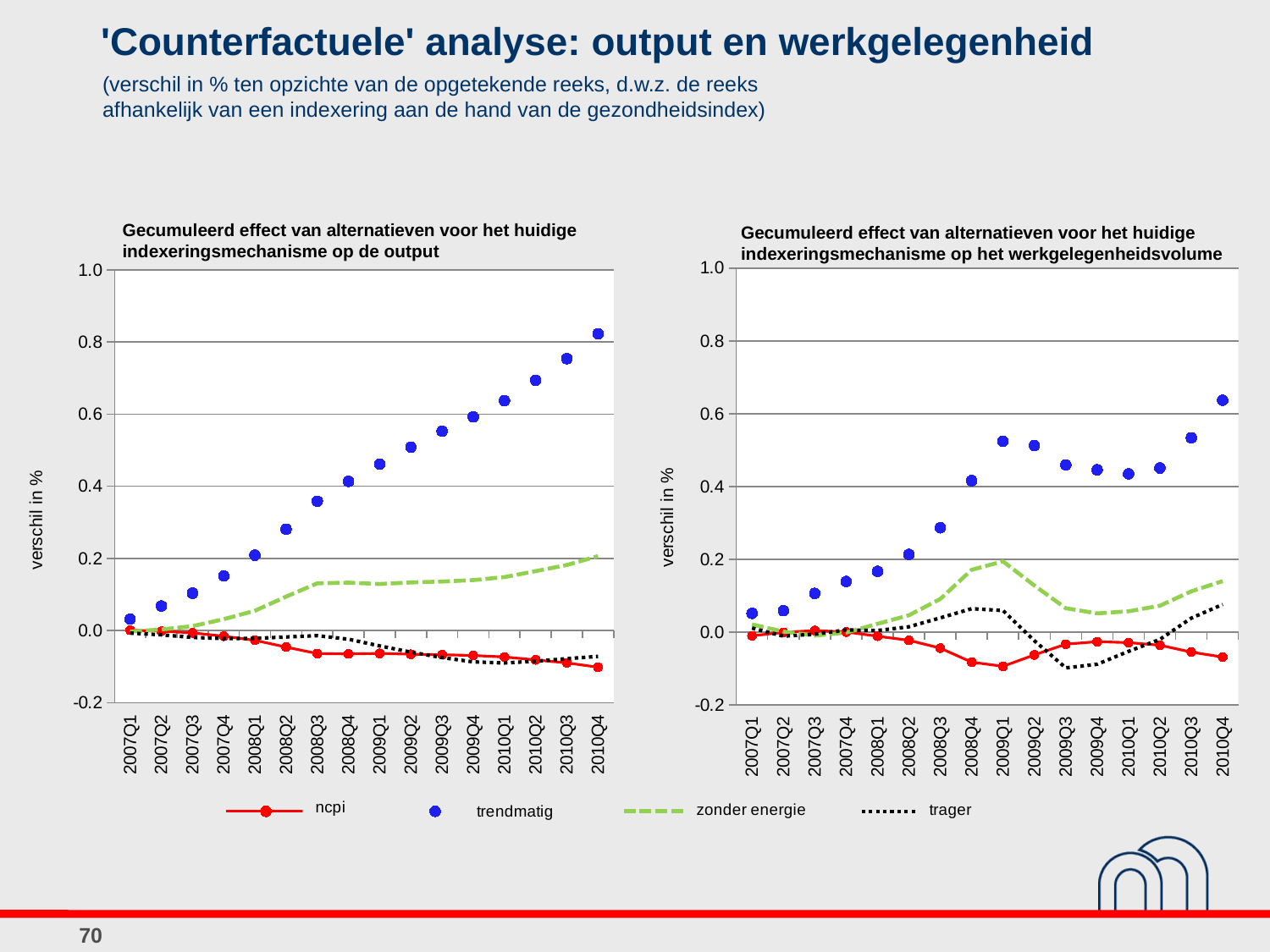
In the right chart (werkgelegenheidsvolume), is the value of trendmatig at 2010Q4 greater or less than 0.4? greater What kind of chart is the left chart, 'Gecumuleerd effect van alternatieven voor het huidige indexeringsmechanisme op de output'? line chart How many quarters are shown on the x axis of the right chart, 'Gecumuleerd effect ... op het werkgelegenheidsvolume'? 16 Is the trendmatig value at 2010Q4 larger in the left chart (output) or in the right chart (werkgelegenheidsvolume)? left chart (output) In the left chart (output), does the trendmatig series rise or fall from 2007Q1 to 2010Q4? rise In the left chart (output), is the value of ncpi at 2010Q4 greater or less than 0.0? less In the right chart (werkgelegenheidsvolume), which series has the lowest value at 2010Q4? ncpi In the left chart (output), is the value of trendmatig at 2010Q4 greater or less than 0.6? greater How many series does the shared legend below the charts list? 4 In the left chart (output), which series has the highest value at 2010Q4? trendmatig What is the y-axis label on the left chart? verschil in % Which series in the legend is drawn with a green dashed line? zonder energie